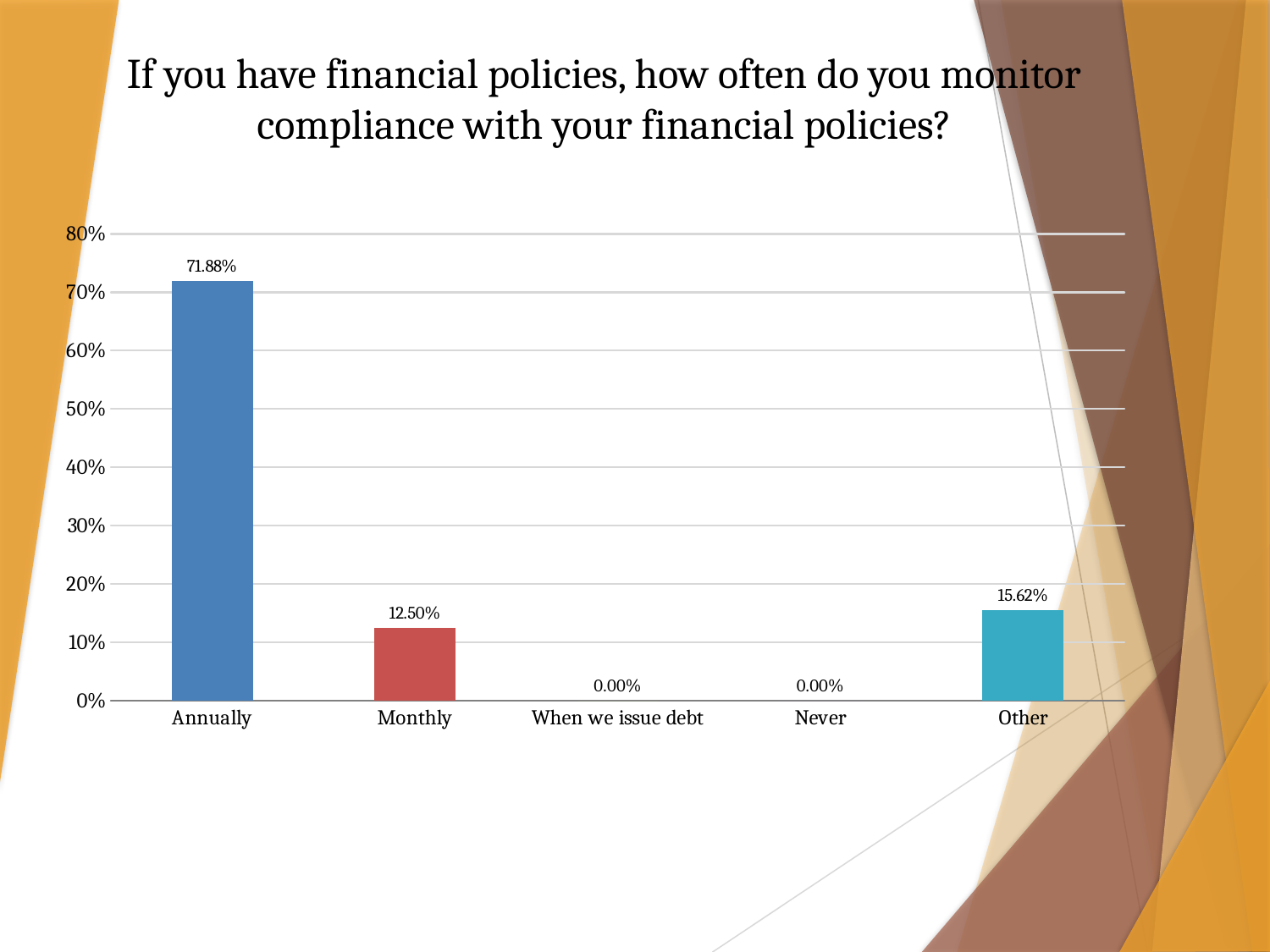
What is the difference between the Other and Monthly values? 3.12% Which is larger, the value for Monthly or the value for Other? Other What is the value shown for the Other category? 15.62% Which category has the highest value? Annually What percentage of respondents monitor compliance with their financial policies annually? 71.88% What kind of chart is shown on the slide? Bar chart What is the title of the chart? If you have financial policies, how often do you monitor compliance with your financial policies? What is the difference between the Annually and Other values? 56.26% Is the value for Annually greater or less than 70%? greater What is the value shown for the Monthly category? 12.50% How many categories are shown on the x axis? 5 What is the value shown for the Never category? 0.00%